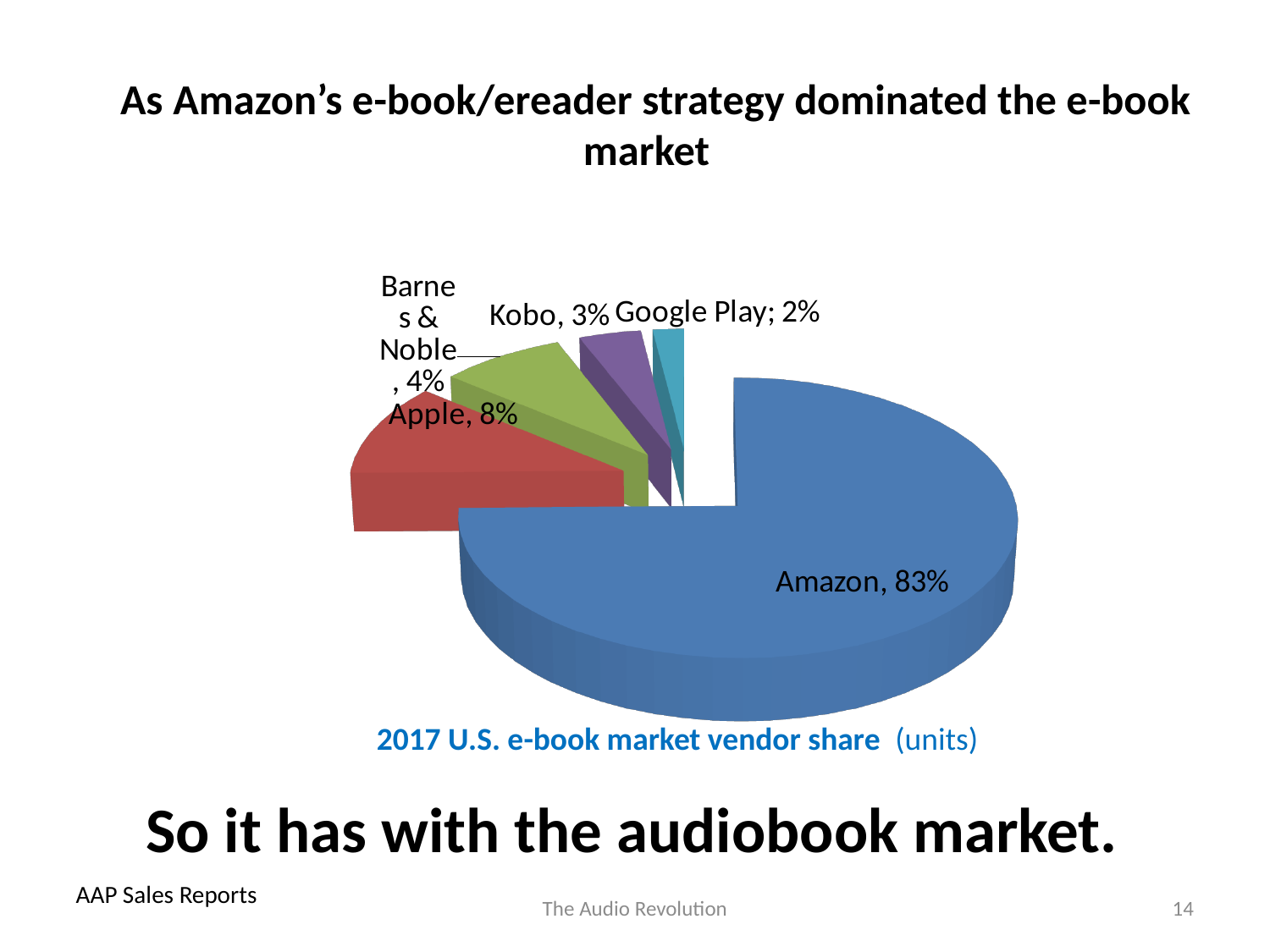
What is the title of the chart? 2017 U.S. e-book market vendor share (units) Which has a larger share of the 2017 U.S. e-book market, Kobo or Barnes & Noble? Barnes & Noble What share of the 2017 U.S. e-book market does Kobo hold? 3% Which vendor has the largest share of the 2017 U.S. e-book market? Amazon What kind of chart is shown on the slide? Pie chart What share of the 2017 U.S. e-book market does Barnes & Noble hold? 4% What share of the 2017 U.S. e-book market does Google Play hold? 2% What share of the 2017 U.S. e-book market does Apple hold? 8% How many percentage points larger is Amazon's share than Apple's share? 75 How many vendors are shown in the pie chart? 5 Which vendor has the smallest share of the 2017 U.S. e-book market? Google Play What share of the 2017 U.S. e-book market does Amazon hold? 83%